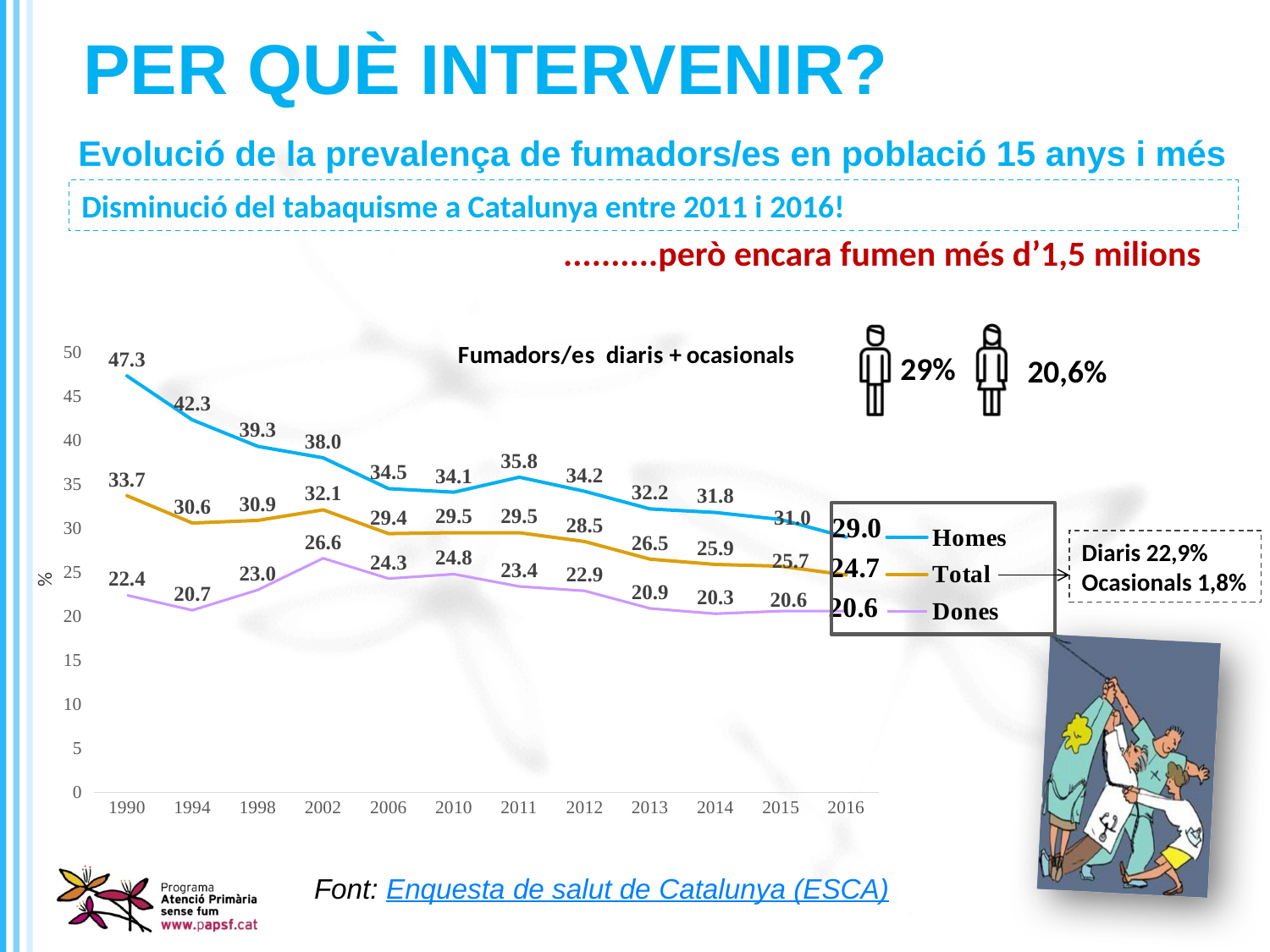
In which year is the Dones series at its lowest? 2014 Which is larger, the Total value in 2002 or the Total value in 2006? 2002 How many years are plotted along the x axis of the chart? 12 What is the title printed inside the chart area? Fumadors/es diaris + ocasionals What is the value for Total in 2016? 24.7 What is the difference between the Homes and Dones values in 2016? 8.4 What type of chart is shown on the slide? line chart Does the Homes series generally rise or fall from 1990 to 2016? fall In which year is the Homes series at its highest? 1990 What is the value for Dones in 2002? 26.6 What is the value for Homes in 1990? 47.3 How many series does the chart legend list? 3